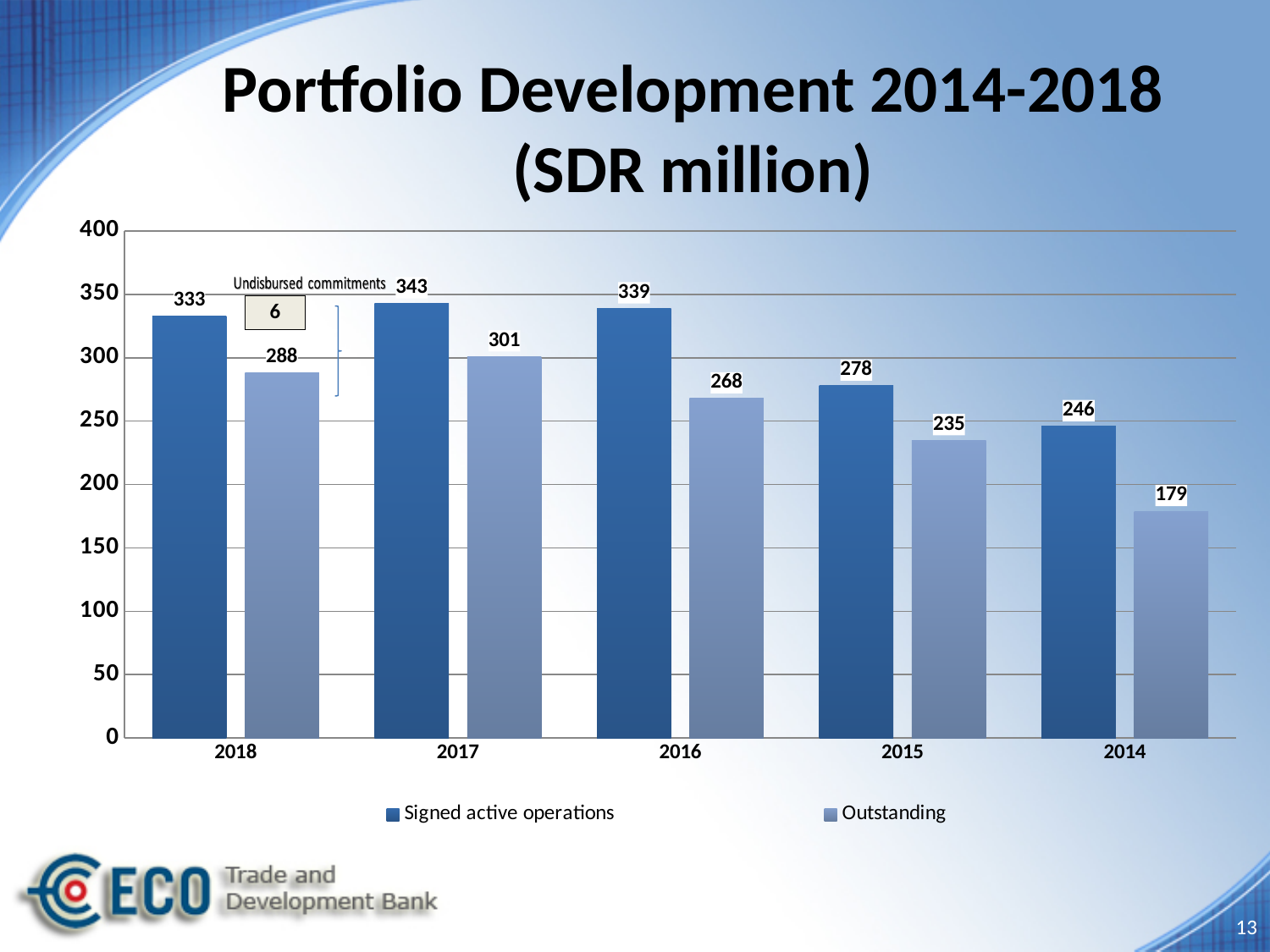
What kind of chart is shown on the slide? Bar chart What is the difference between Signed active operations and Outstanding in 2015? 43 How many series does the legend list? 2 Which year has the lowest Outstanding value? 2014 What is the value shown for Undisbursed commitments in 2018? 6 What is the Outstanding value for 2016? 268 What is the value of Signed active operations for 2018? 333 Which year has the highest Signed active operations value? 2017 How many years are shown on the x axis? 5 What is the Outstanding value for 2014? 179 Which is larger, Signed active operations in 2016 or Signed active operations in 2018? Signed active operations in 2016 What is the title of the chart? Portfolio Development 2014-2018 (SDR million)